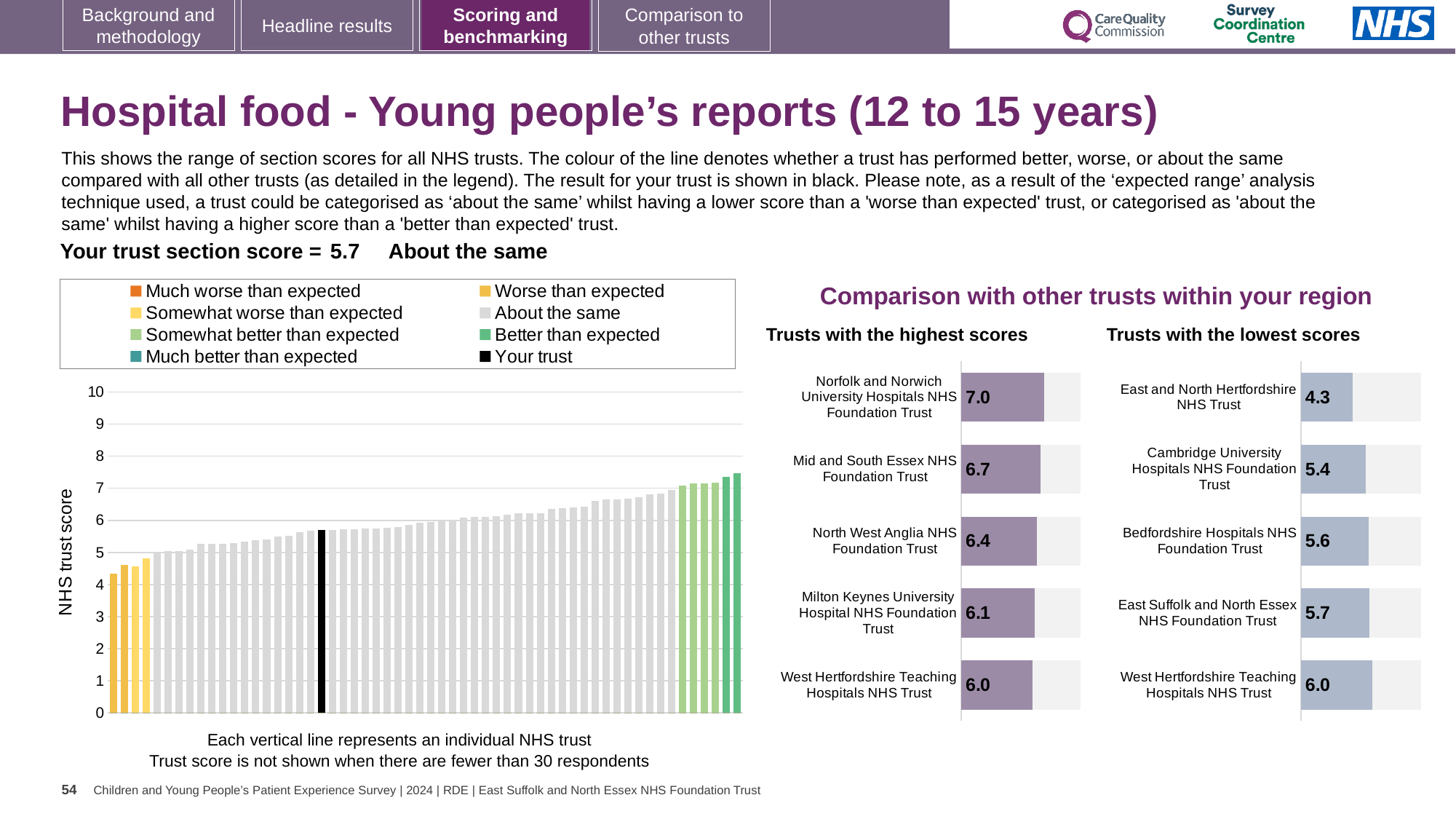
In the 'Trusts with the lowest scores' chart, which trust has the lowest score? East and North Hertfordshire NHS Trust How many trusts are shown in the 'Trusts with the lowest scores' chart? 5 In the 'Trusts with the lowest scores' chart, what is the score for Cambridge University Hospitals NHS Foundation Trust? 5.4 How many entries does the legend of the NHS trust score chart list? 8 In the 'Trusts with the highest scores' chart, what is the difference between the scores of Norfolk and Norwich University Hospitals NHS Foundation Trust and West Hertfordshire Teaching Hospitals NHS Trust? 1.0 In the 'Trusts with the lowest scores' chart, what is the difference between the scores of West Hertfordshire Teaching Hospitals NHS Trust and East and North Hertfordshire NHS Trust? 1.7 In the 'Trusts with the highest scores' chart, which has the larger score: Mid and South Essex NHS Foundation Trust or North West Anglia NHS Foundation Trust? Mid and South Essex NHS Foundation Trust In the 'Trusts with the highest scores' chart, what is the score for Norfolk and Norwich University Hospitals NHS Foundation Trust? 7.0 In the 'Trusts with the highest scores' chart, which trust has the highest score? Norfolk and Norwich University Hospitals NHS Foundation Trust In the 'Trusts with the highest scores' chart, what is the score for Milton Keynes University Hospital NHS Foundation Trust? 6.1 In the NHS trust score chart on the left, do the bar values rise or fall from left to right? Rise What kind of chart is the NHS trust score chart on the left of the slide? Bar chart